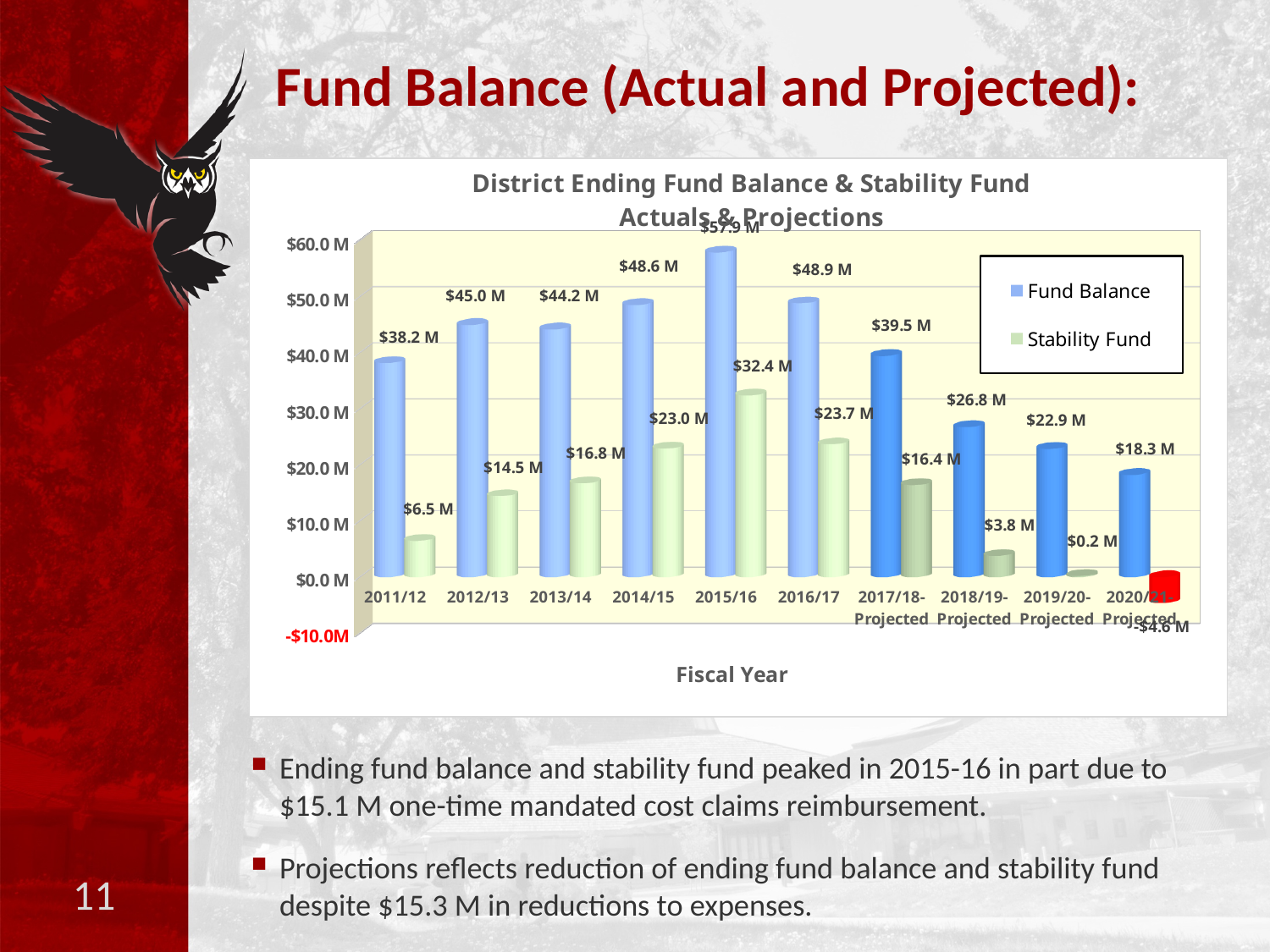
What is the difference between the Stability Fund in 2015/16 and in 2016/17? $8.7 M What is the difference between the Fund Balance in 2014/15 and in 2013/14? $4.4 M Does the Fund Balance rise or fall from 2017/18-Projected to 2020/21-Projected? Fall Which fiscal year has the larger Fund Balance, 2012/13 or 2013/14? 2012/13 What is the Fund Balance value for 2015/16? $57.9 M What kind of chart is shown on the slide? Bar chart How many series does the legend list? 2 How many fiscal years are shown on the x axis? 10 In which fiscal year is the Fund Balance highest? 2015/16 In which fiscal year is the Stability Fund lowest? 2020/21-Projected What is the Stability Fund value for 2013/14? $16.8 M What is the Stability Fund value for 2020/21-Projected? -$4.6 M